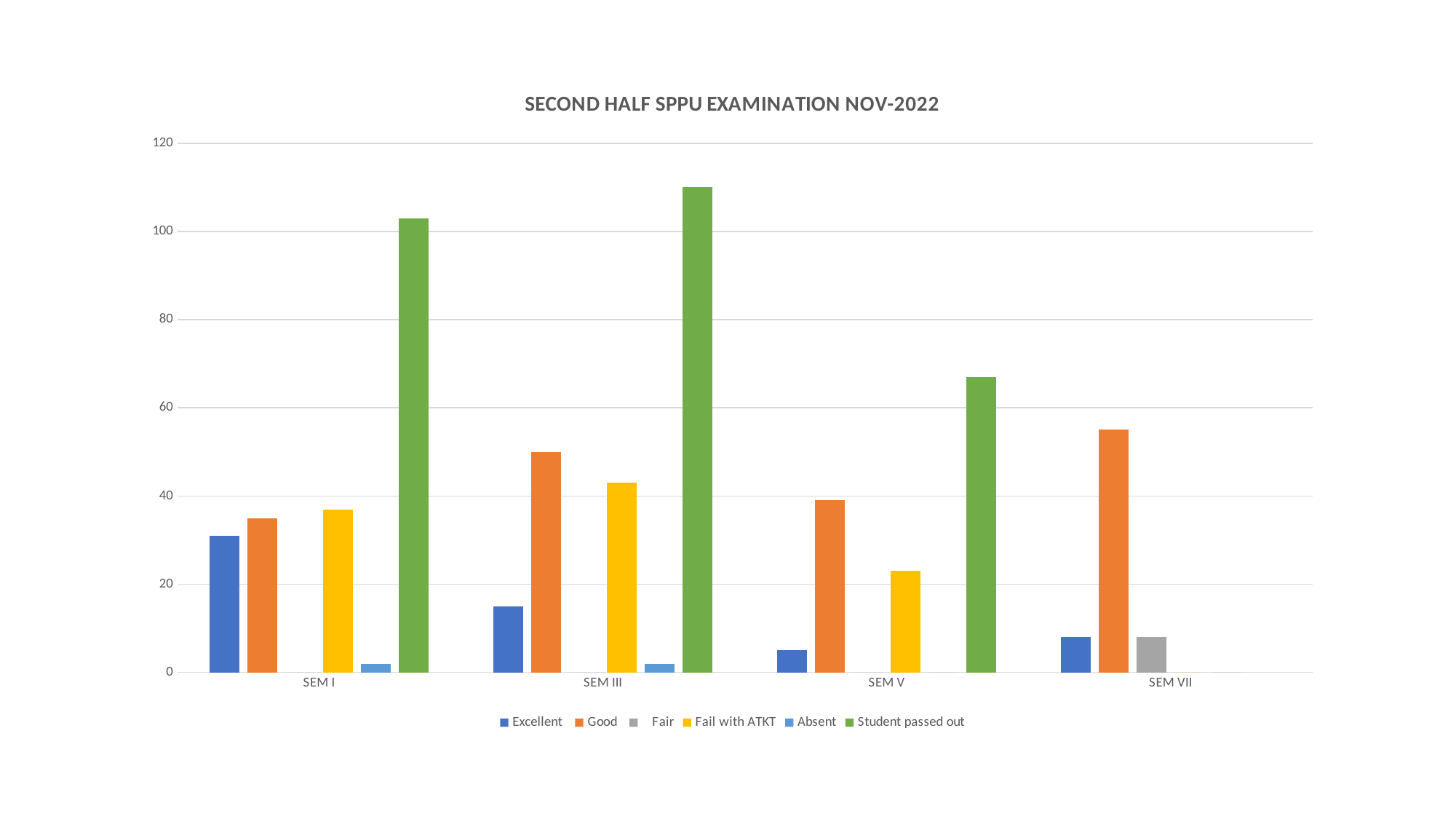
What is the title of the chart? SECOND HALF SPPU EXAMINATION NOV-2022 What kind of chart is shown on the slide? bar chart How many semester categories are shown on the x axis? 4 What colour represents the Student passed out series in the legend? green Which is larger, the Good value for SEM III or the Good value for SEM V? SEM III Is the value for Student passed out in SEM I greater or less than 100? greater Is the value for Good in SEM VII greater or less than 60? less Which semester has the lowest value for Excellent? SEM V Is the value for Fail with ATKT in SEM V greater or less than 20? greater Does the Excellent value rise or fall from SEM I to SEM V? falls How many series does the legend list? 6 Which semester has the highest value for Student passed out? SEM III